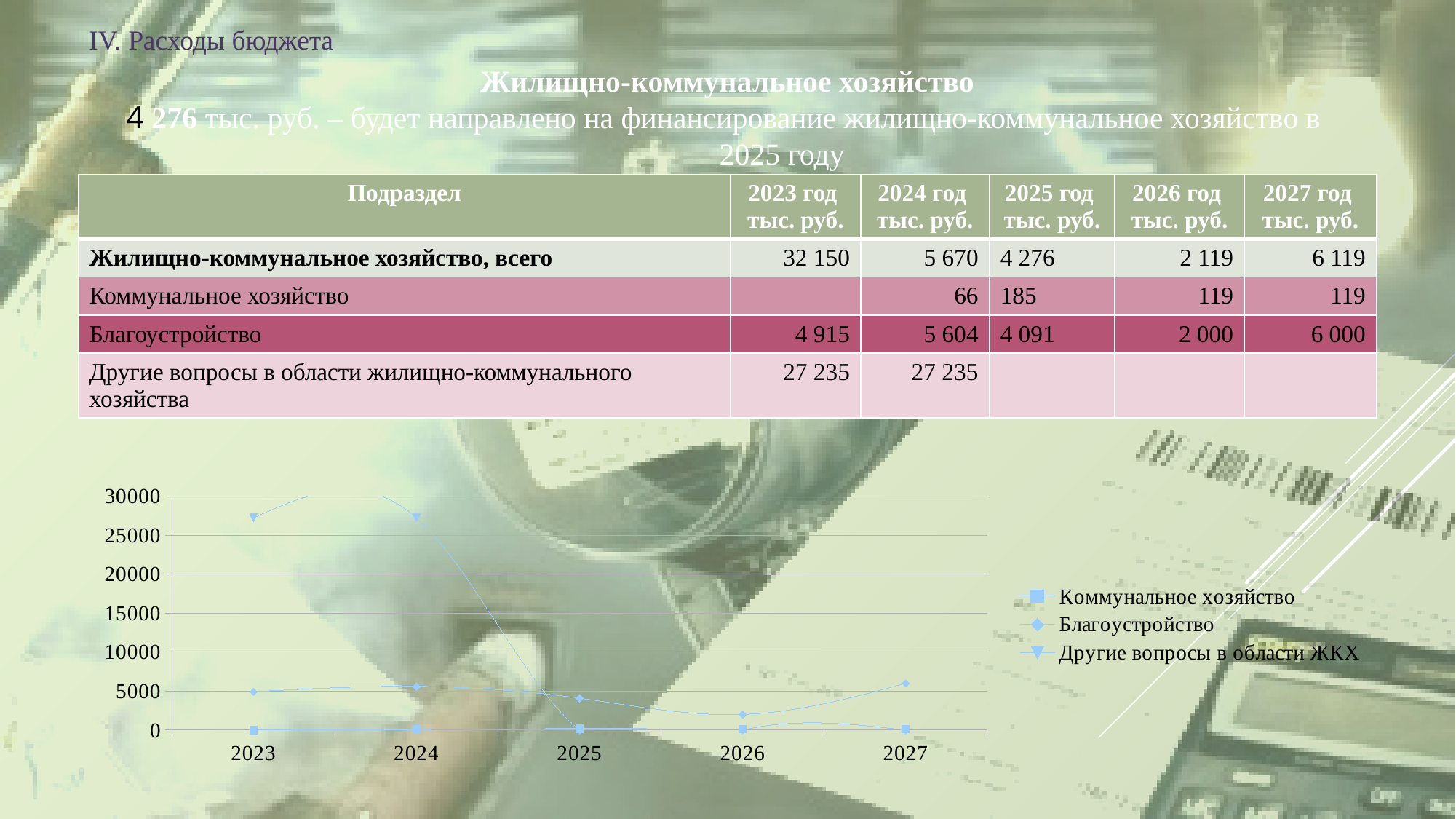
Does the Другие вопросы в области ЖКХ line rise or fall from 2024 to 2025? fall What kind of chart is shown on the slide? line chart Is the value for Благоустройство in 2023 greater or less than 10000? less How many years are shown along the x axis of the chart? 5 Is the value for Другие вопросы в области ЖКХ in 2023 greater or less than 25000? greater Which series is listed first in the chart legend? Коммунальное хозяйство In 2025, which is larger: Благоустройство or Коммунальное хозяйство? Благоустройство In which year is the Благоустройство line at its highest? 2027 According to the table on the slide, what is the value for Благоустройство in 2025 (тыс. руб.)? 4 091 How many series does the chart legend list? 3 Does the Благоустройство line rise or fall from 2024 to 2026? fall In which year is the Благоустройство line at its lowest? 2026